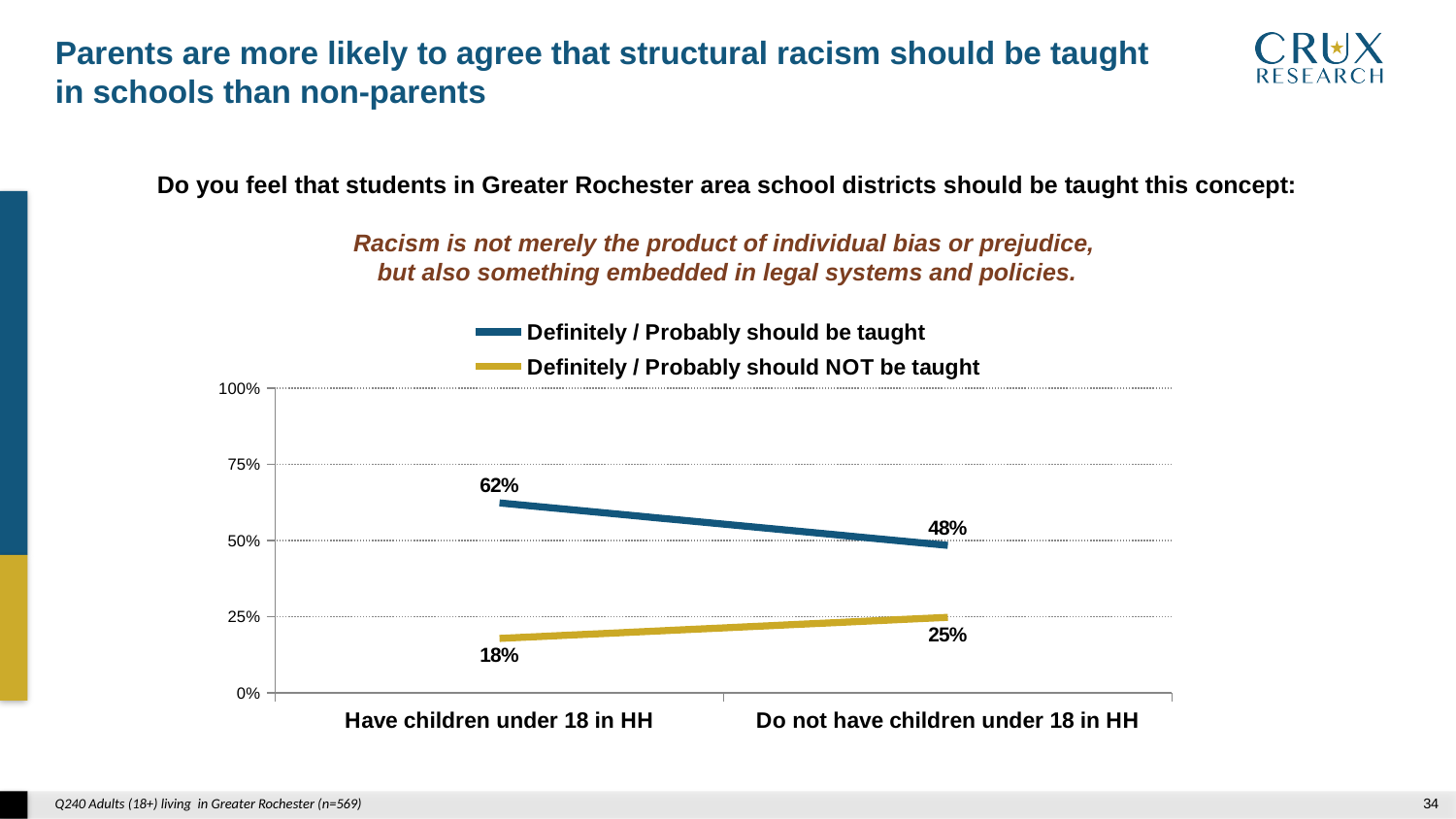
How many series does the legend list? 2 How many categories are shown on the x axis? 2 What percentage of respondents who do not have children under 18 in HH say the concept definitely/probably should NOT be taught? 25% Which group has the higher 'Definitely / Probably should be taught' percentage? Have children under 18 in HH Which group has the lower 'Definitely / Probably should NOT be taught' percentage? Have children under 18 in HH Does the 'Definitely / Probably should be taught' line rise or fall from 'Have children under 18 in HH' to 'Do not have children under 18 in HH'? Fall What kind of chart is shown on the slide? Line chart What percentage of respondents who have children under 18 in HH say the concept definitely/probably should be taught? 62% What percentage of respondents who do not have children under 18 in HH say the concept definitely/probably should be taught? 48% What is the difference in the 'Definitely / Probably should be taught' percentage between those with children under 18 in HH and those without? 14 percentage points What is the difference in the 'Definitely / Probably should NOT be taught' percentage between those without children under 18 in HH and those with? 7 percentage points What percentage of respondents who have children under 18 in HH say the concept definitely/probably should NOT be taught? 18%